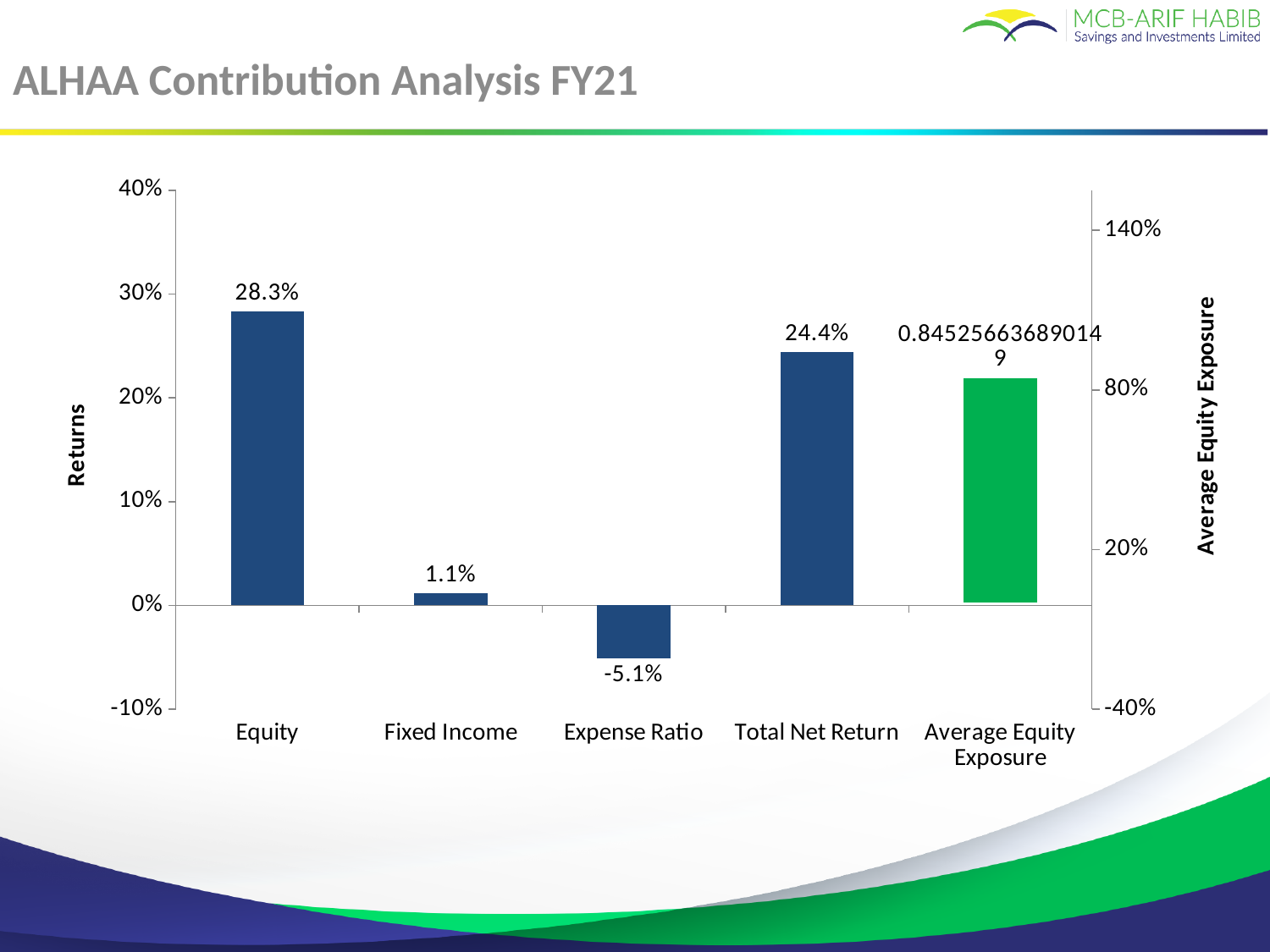
How many categories are shown on the x axis? 5 What is the value for Expense Ratio? -5.1% What is the data label shown for Average Equity Exposure? 0.845256636890149 Which category on the Returns axis has the highest value? Equity What is the difference between the Equity value and the Total Net Return value? 3.9% Which is larger, the value for Equity or the value for Total Net Return? Equity Which category has the lowest value? Expense Ratio What is the value for Equity? 28.3% What is the value for Fixed Income? 1.1% What is the value for Total Net Return? 24.4% What is the title of the slide? ALHAA Contribution Analysis FY21 What kind of chart is shown on the slide? Bar chart